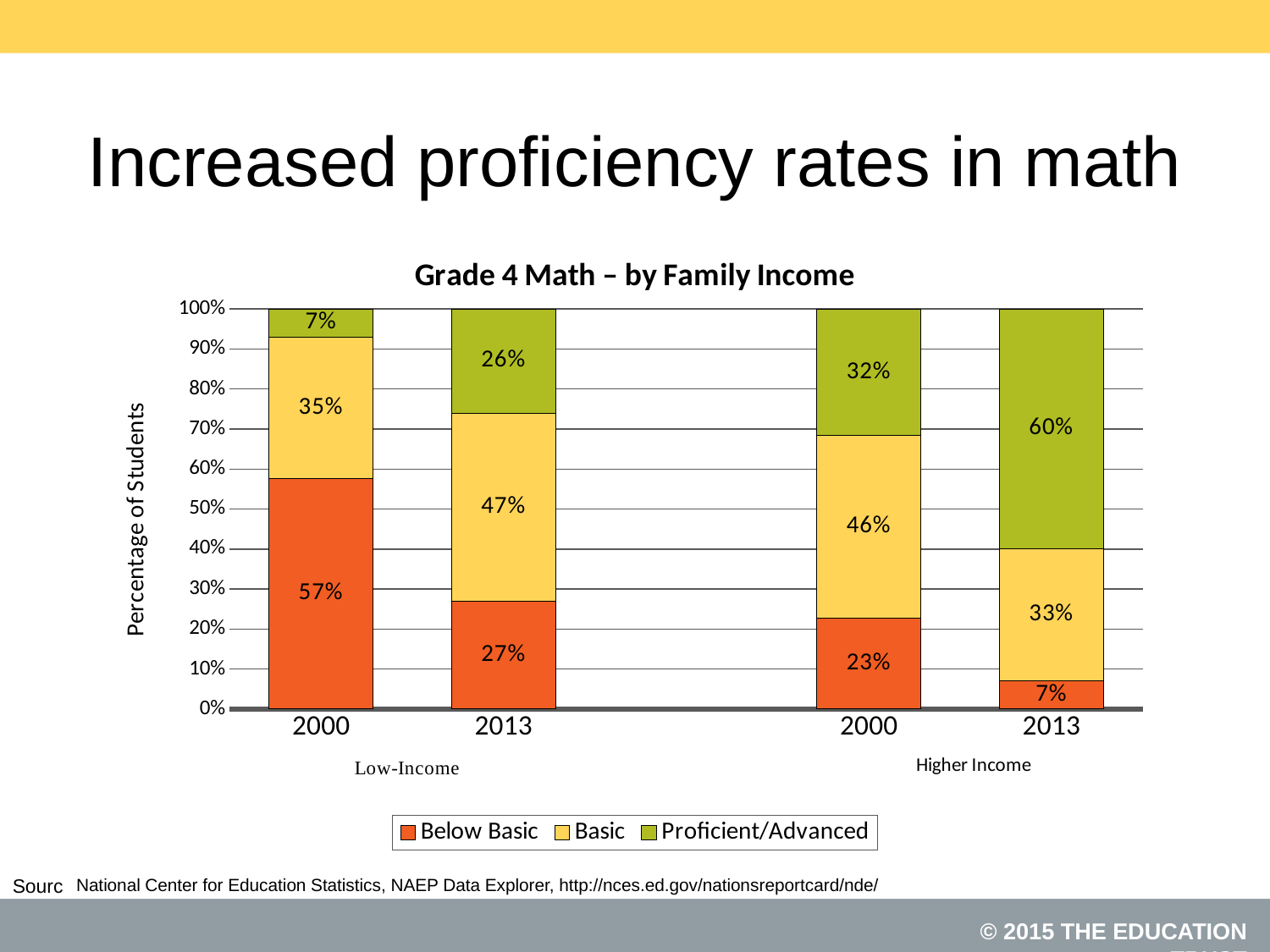
Which bar has the highest Proficient/Advanced percentage? Higher Income 2013 Which bar has the lowest Below Basic percentage? Higher Income 2013 What is the title of the chart? Grade 4 Math – by Family Income Which is larger: the Basic share for Low-Income students in 2013 or for Higher Income students in 2000? Low-Income 2013 What kind of chart is shown? Stacked bar chart What is the Proficient/Advanced percentage for Higher Income students in 2013? 60% What is the Proficient/Advanced percentage for Low-Income students in 2013? 26% What is the Below Basic percentage for Higher Income students in 2000? 23% What is the Basic percentage for Low-Income students in 2000? 35% By how many percentage points did the Below Basic share for Low-Income students fall from 2000 to 2013? 30 How many bars are plotted in the chart? 4 How many series does the legend list? 3